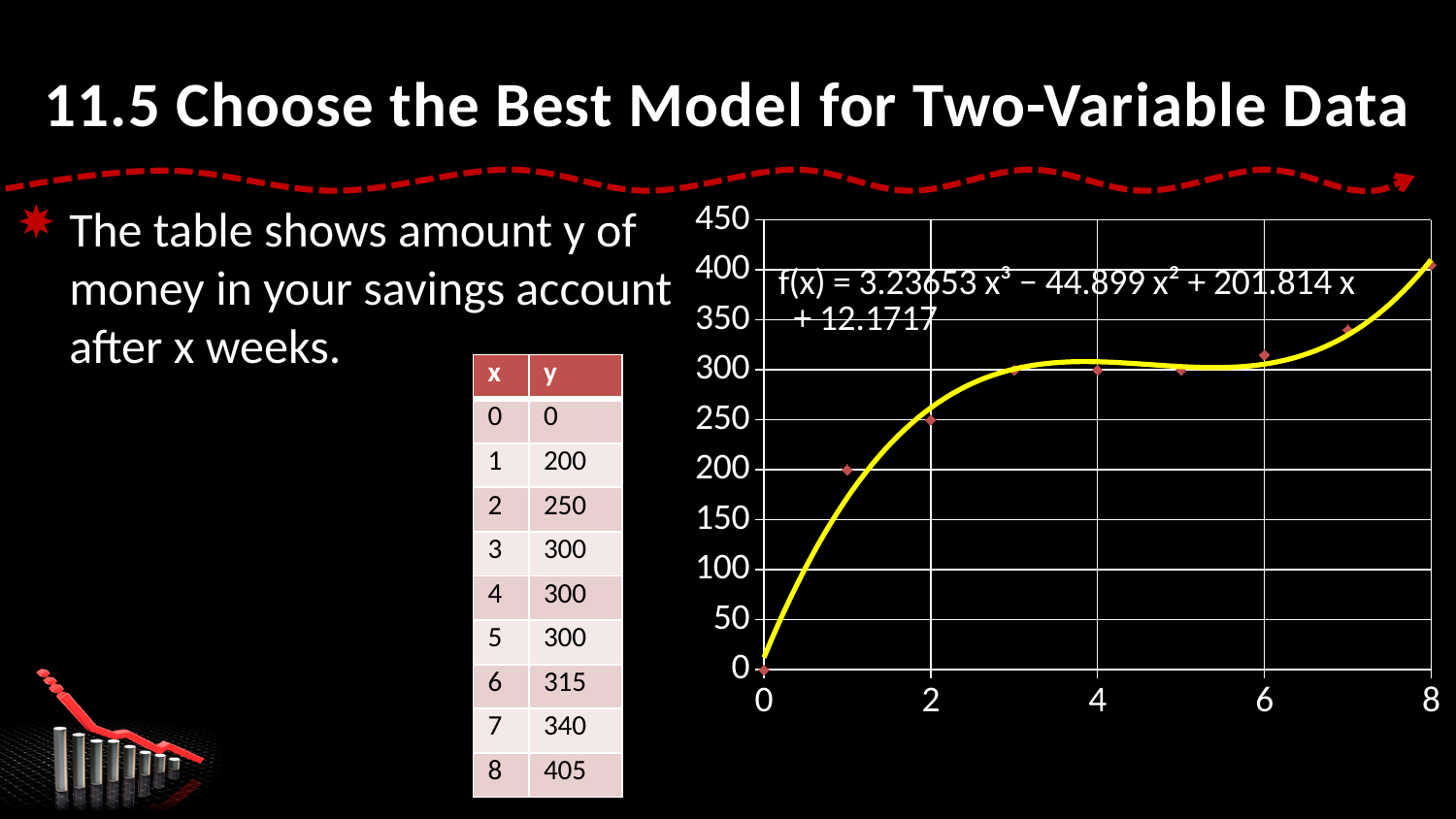
What is the value of y when x = 6? 315 Is the value of y at x = 7 greater or less than 300? greater At which x value is y the highest? 8 What kind of chart is shown on the slide? scatter chart How many data points are plotted on the chart? 9 What is the degree of the polynomial trendline equation shown on the chart? 3 Do the y values generally rise or fall as x increases? rise Which is larger, y at x = 1 or y at x = 2? x = 2 What is the value of y when x = 2? 250 What is the value of y when x = 8? 405 What is the difference between y at x = 7 and y at x = 6? 25 At which x value is y the lowest? 0